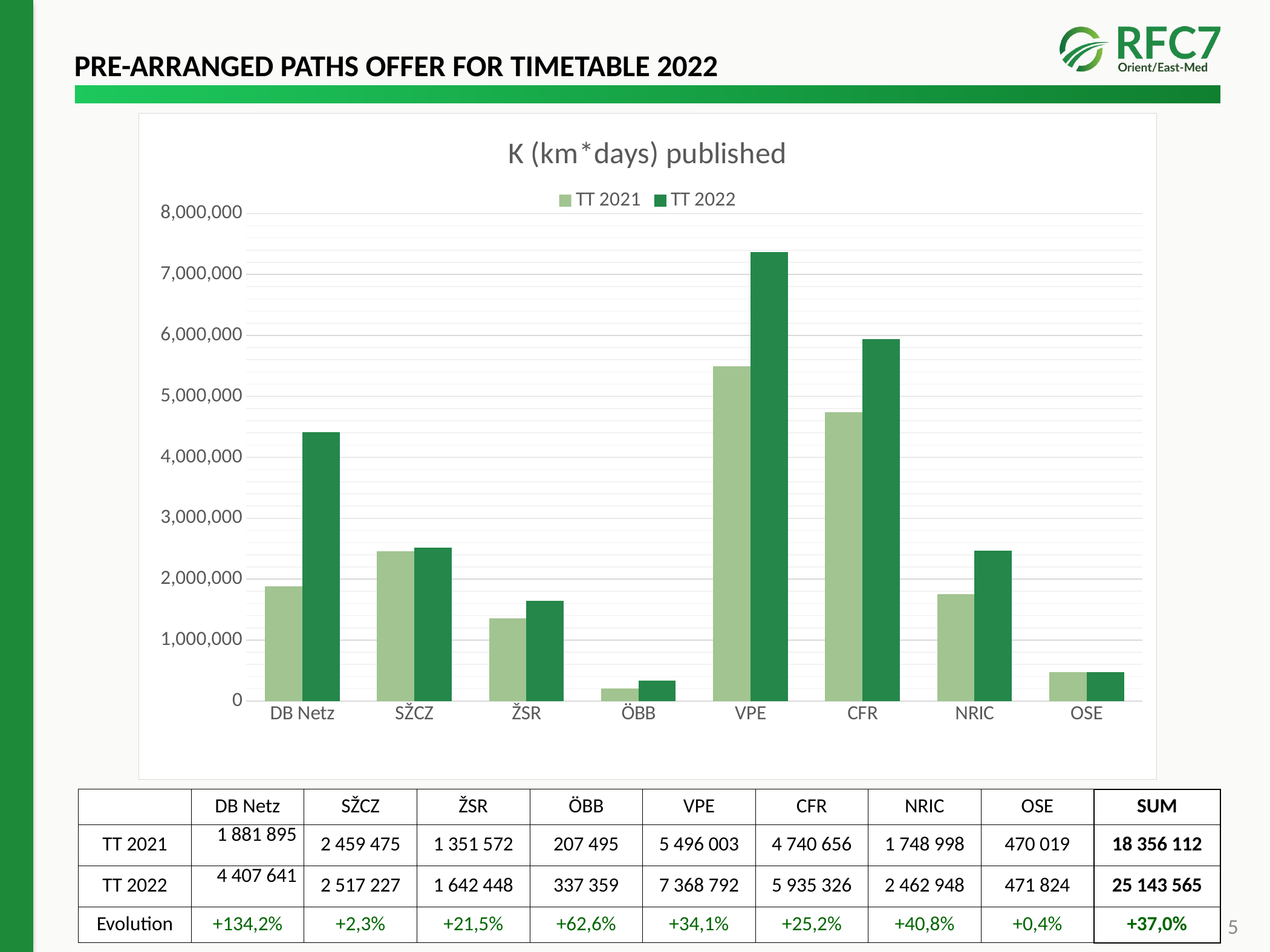
How many categories are shown on the x axis of the chart? 8 Which is larger, the TT 2022 value for CFR or the TT 2022 value for NRIC? CFR What is the title of the chart? K (km*days) published What kind of chart is shown on the slide? bar chart Which category has the highest TT 2022 value? VPE What is the difference between the TT 2022 and TT 2021 values for DB Netz? 2 525 746 What is the TT 2022 value for DB Netz? 4 407 641 How many series does the chart legend list? 2 What is the TT 2021 value for VPE? 5 496 003 What is the Evolution percentage shown for NRIC? +40,8% Which category has the lowest TT 2021 value? ÖBB Is the TT 2022 value for VPE greater or less than 7,000,000? greater